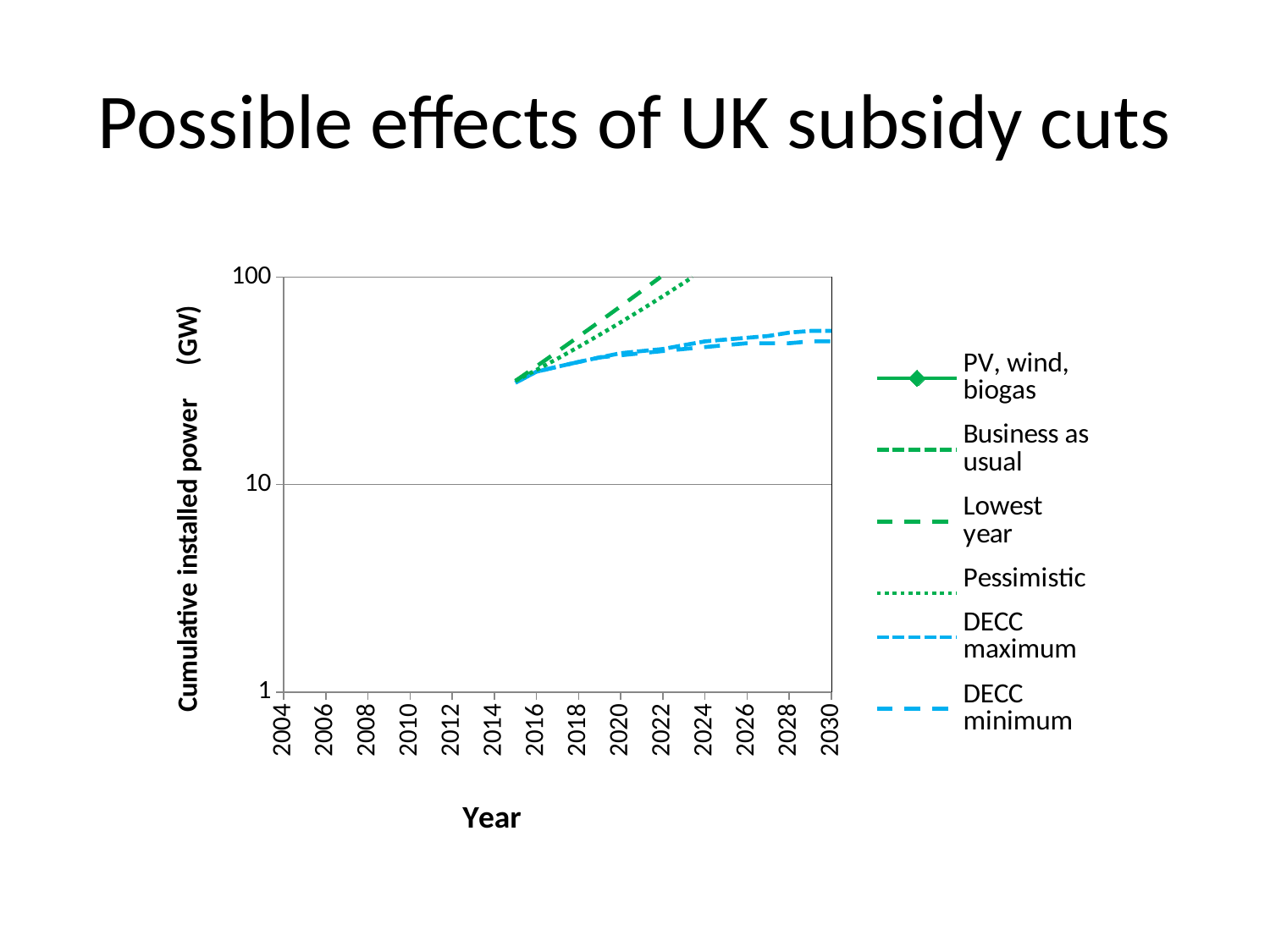
What is the label of the vertical axis? Cumulative installed power (GW) Is the value for Lowest year in 2020 greater or less than 10? greater In 2022, which is higher: Pessimistic or DECC minimum? Pessimistic How many series does the legend list? 6 Does the DECC minimum series rise or fall from 2015 to 2030? rise Is the value for Pessimistic in 2020 greater or less than 100? less In 2020, which is higher: Lowest year or DECC maximum? Lowest year Is the value for DECC maximum in 2030 greater or less than 10? greater What is the title of the slide? Possible effects of UK subsidy cuts What kind of chart is shown on the slide? line chart Does the Lowest year series rise or fall after 2015? rise